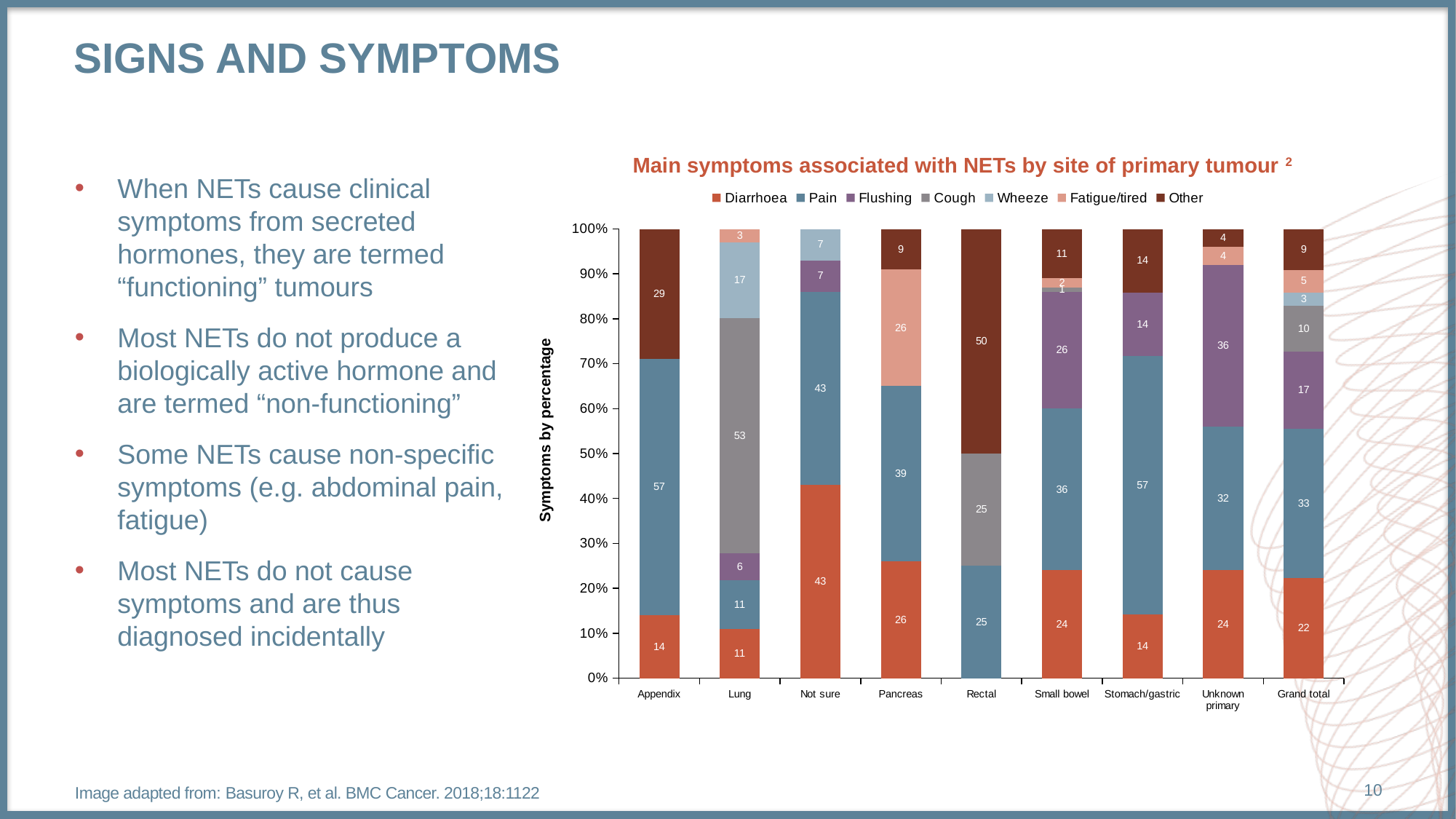
What is the Pain value for Appendix? 57 What kind of chart is shown? Stacked bar chart What is the Other value for Rectal? 50 Which site has the highest Other value? Rectal What is the Flushing value for Unknown primary? 36 Which site has the highest Diarrhoea value? Not sure How many sites of primary tumour are shown on the x axis? 9 How many symptom series does the legend list? 7 What is the label of the y axis? Symptoms by percentage Which is larger, the Flushing value for Small bowel or the Flushing value for Stomach/gastric? Small bowel What is the difference between the Pain value for Stomach/gastric and the Pain value for Grand total? 24 What is the Cough value for Lung? 53